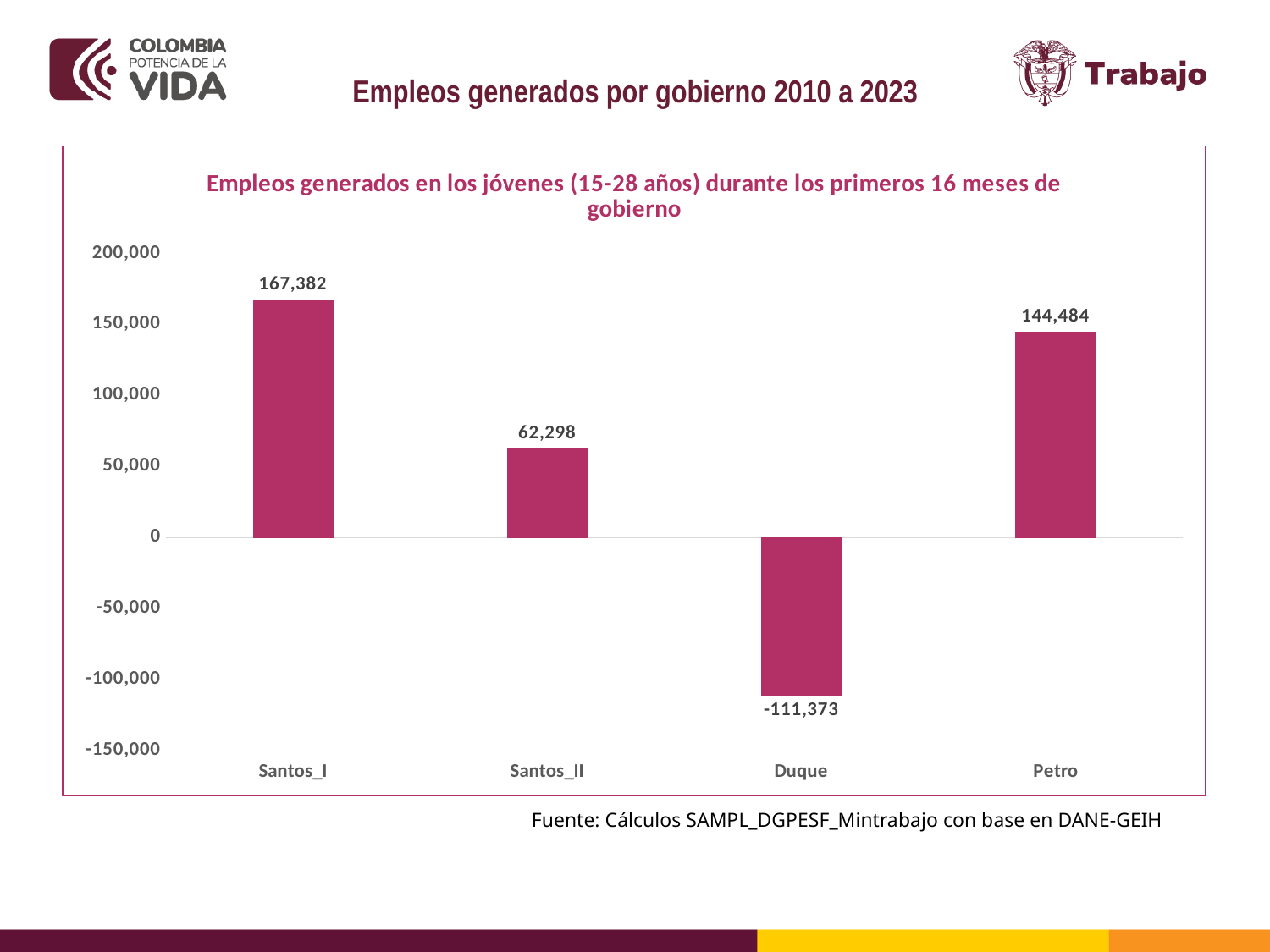
What is the value for Duque? -111,373 Is the value for Santos_II greater or less than 100,000? less What kind of chart is shown? bar chart Which government has the highest value? Santos_I What is the value for Petro? 144,484 What is the difference between the values for Santos_I and Petro? 22,898 Which is larger, the value for Santos_II or the value for Petro? Petro What is the title of the chart? Empleos generados en los jóvenes (15-28 años) durante los primeros 16 meses de gobierno What is the value for Santos_II? 62,298 What is the value for Santos_I? 167,382 Which government has the lowest value? Duque How many governments are shown on the x axis? 4